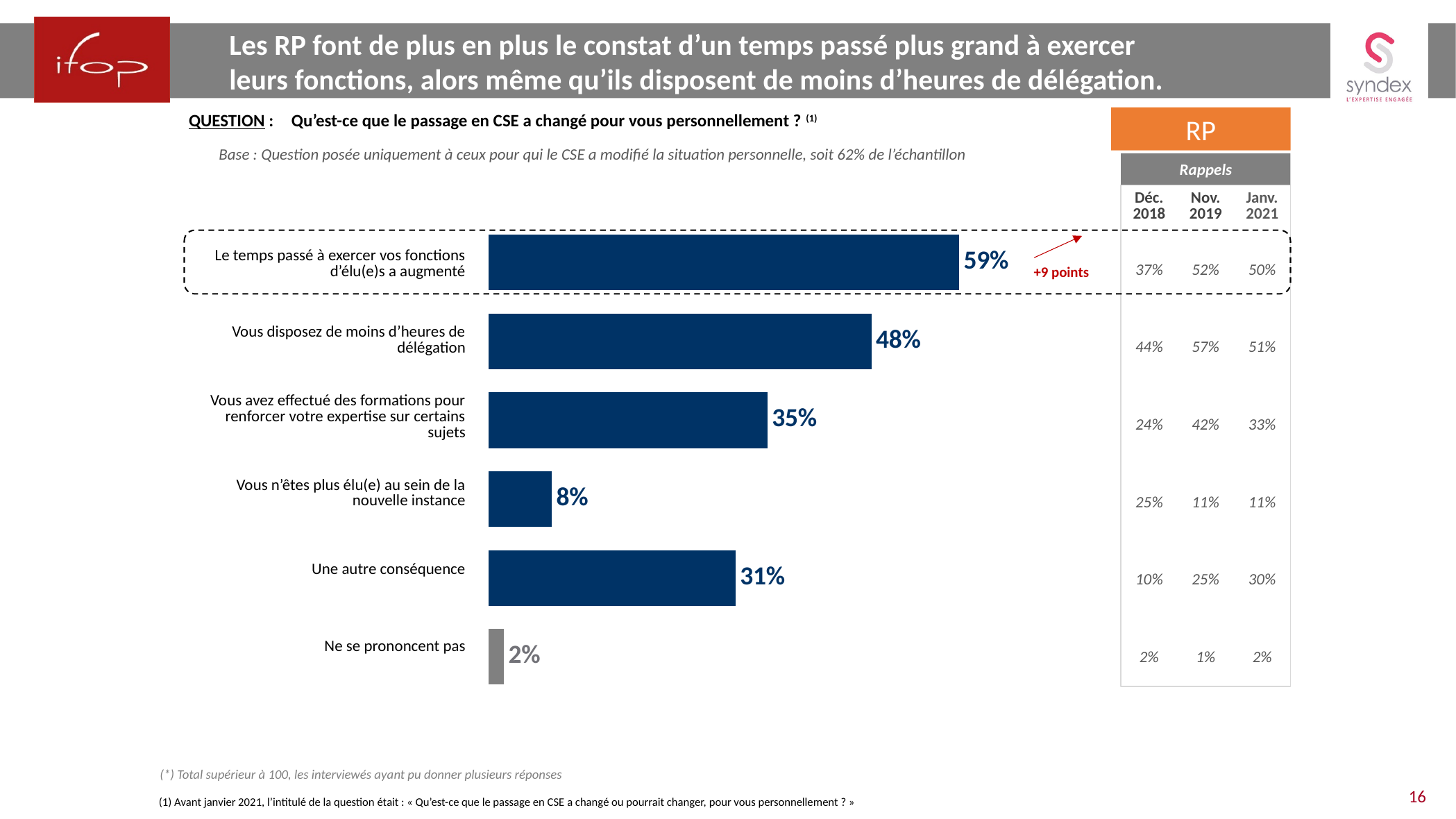
What is the value for "Vous n'êtes plus élu(e) au sein de la nouvelle instance"? 8% How many categories are shown in the bar chart? 6 What kind of chart is shown on the slide? Bar chart What is the value for "Vous disposez de moins d'heures de délégation"? 48% Which category has the highest value? Le temps passé à exercer vos fonctions d'élu(e)s a augmenté In the Rappels table, what was the value for "Le temps passé à exercer vos fonctions d'élu(e)s a augmenté" in Janv. 2021? 50% What is the value for "Une autre conséquence"? 31% Which is larger: the value for "Vous avez effectué des formations pour renforcer votre expertise sur certains sujets" or for "Une autre conséquence"? Vous avez effectué des formations pour renforcer votre expertise sur certains sujets What is the value for "Le temps passé à exercer vos fonctions d'élu(e)s a augmenté"? 59% Which category has the lowest value? Ne se prononcent pas What change in points is annotated next to the top bar? +9 points What is the difference between the values for "Le temps passé à exercer vos fonctions d'élu(e)s a augmenté" and "Vous disposez de moins d'heures de délégation"? 11 points